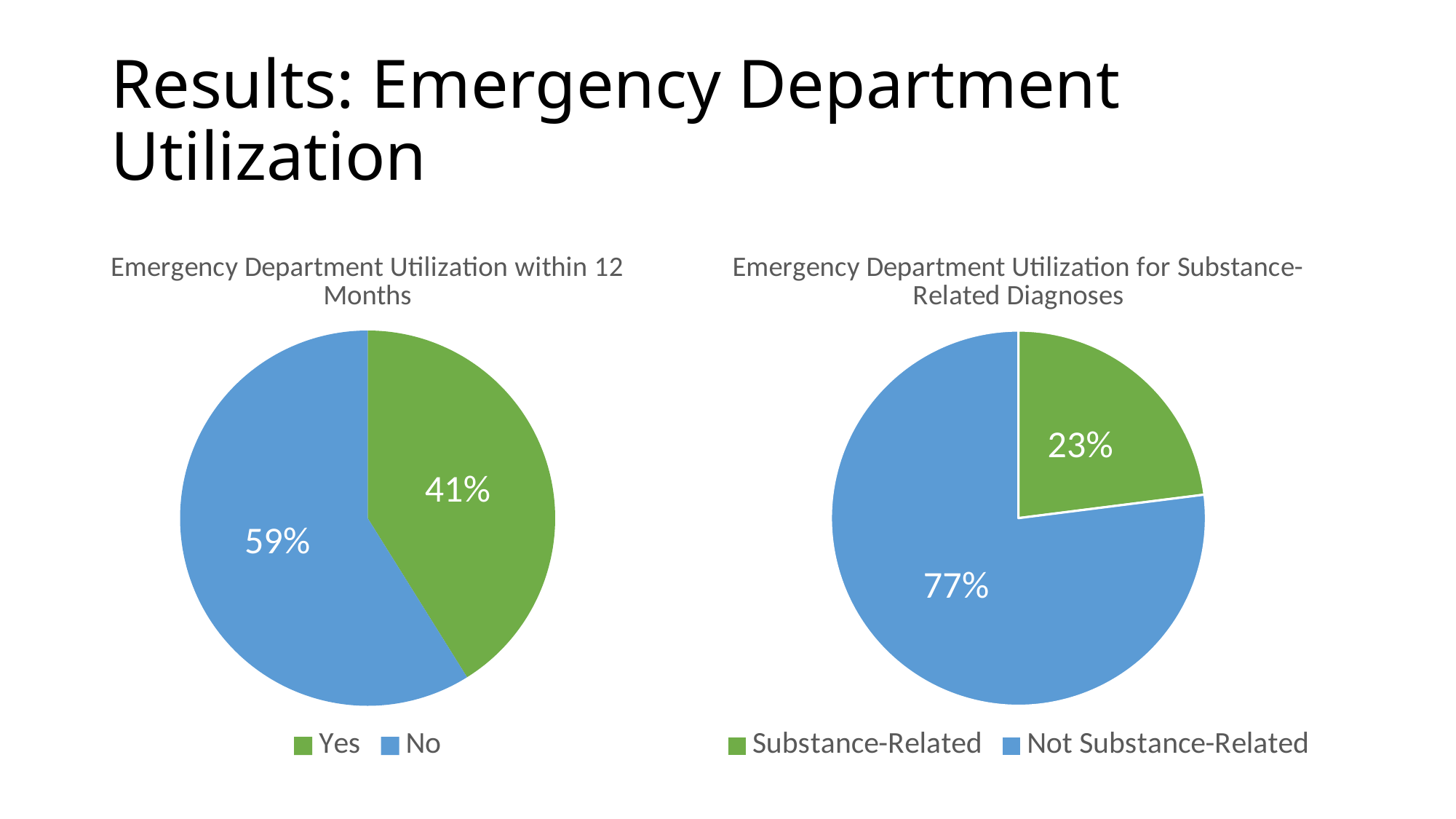
What type of chart is the 'Emergency Department Utilization within 12 Months' chart? Pie chart In the 'Emergency Department Utilization within 12 Months' chart, what percentage is shown for 'Yes'? 41% In the 'Emergency Department Utilization for Substance-Related Diagnoses' chart, what percentage is shown for 'Not Substance-Related'? 77% In the 'Emergency Department Utilization for Substance-Related Diagnoses' chart, which slice is the smallest? Substance-Related In the 'Emergency Department Utilization within 12 Months' chart, what percentage is shown for 'No'? 59% In the 'Emergency Department Utilization for Substance-Related Diagnoses' chart, what is the difference in percentage points between 'Not Substance-Related' and 'Substance-Related'? 54 In the 'Emergency Department Utilization within 12 Months' chart, which slice is the largest? No In the 'Emergency Department Utilization within 12 Months' chart, what is the difference in percentage points between 'No' and 'Yes'? 18 In the 'Emergency Department Utilization within 12 Months' chart, what colour is the 'Yes' slice? Green In the 'Emergency Department Utilization for Substance-Related Diagnoses' chart, which is larger: 'Substance-Related' or 'Not Substance-Related'? Not Substance-Related In the 'Emergency Department Utilization for Substance-Related Diagnoses' chart, what percentage is shown for 'Substance-Related'? 23% How many slices does the 'Emergency Department Utilization for Substance-Related Diagnoses' chart have? 2